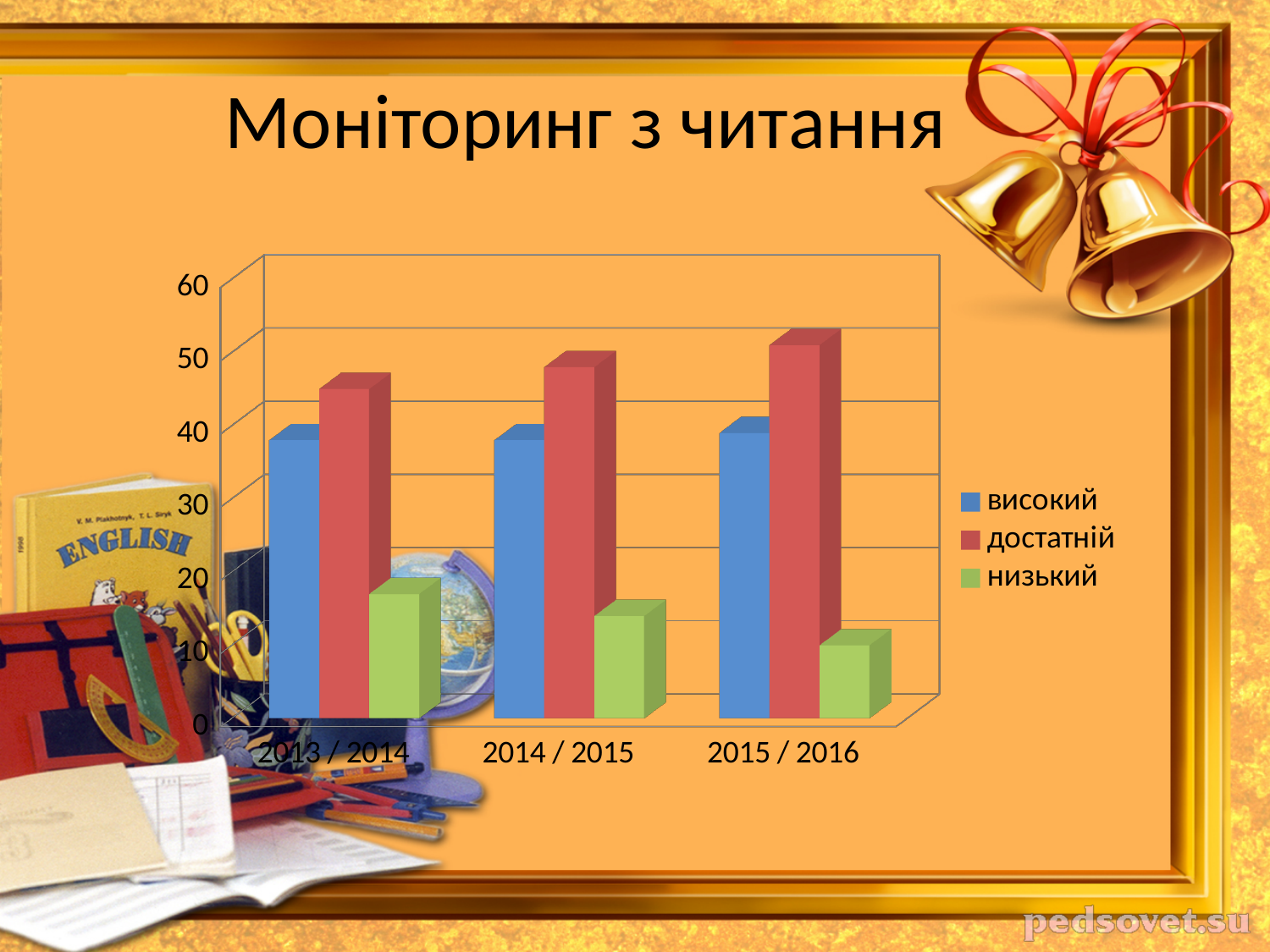
Do the values for низький rise or fall from 2013 / 2014 to 2015 / 2016? fall Which series has the highest value in 2015 / 2016? достатній How many series does the legend list? 3 Is the value for достатній in 2013 / 2014 greater or less than 40? greater Is the value for високий in 2014 / 2015 greater or less than 30? greater How many categories are shown on the x axis? 3 Which is larger: достатній in 2015 / 2016 or достатній in 2013 / 2014? достатній in 2015 / 2016 Is the value for низький in 2015 / 2016 greater or less than 20? less What kind of chart is shown on the slide? bar chart What is the title of the chart on the slide? Моніторинг з читання Which series has the lowest value in 2013 / 2014? низький Do the values for достатній rise or fall from 2013 / 2014 to 2015 / 2016? rise